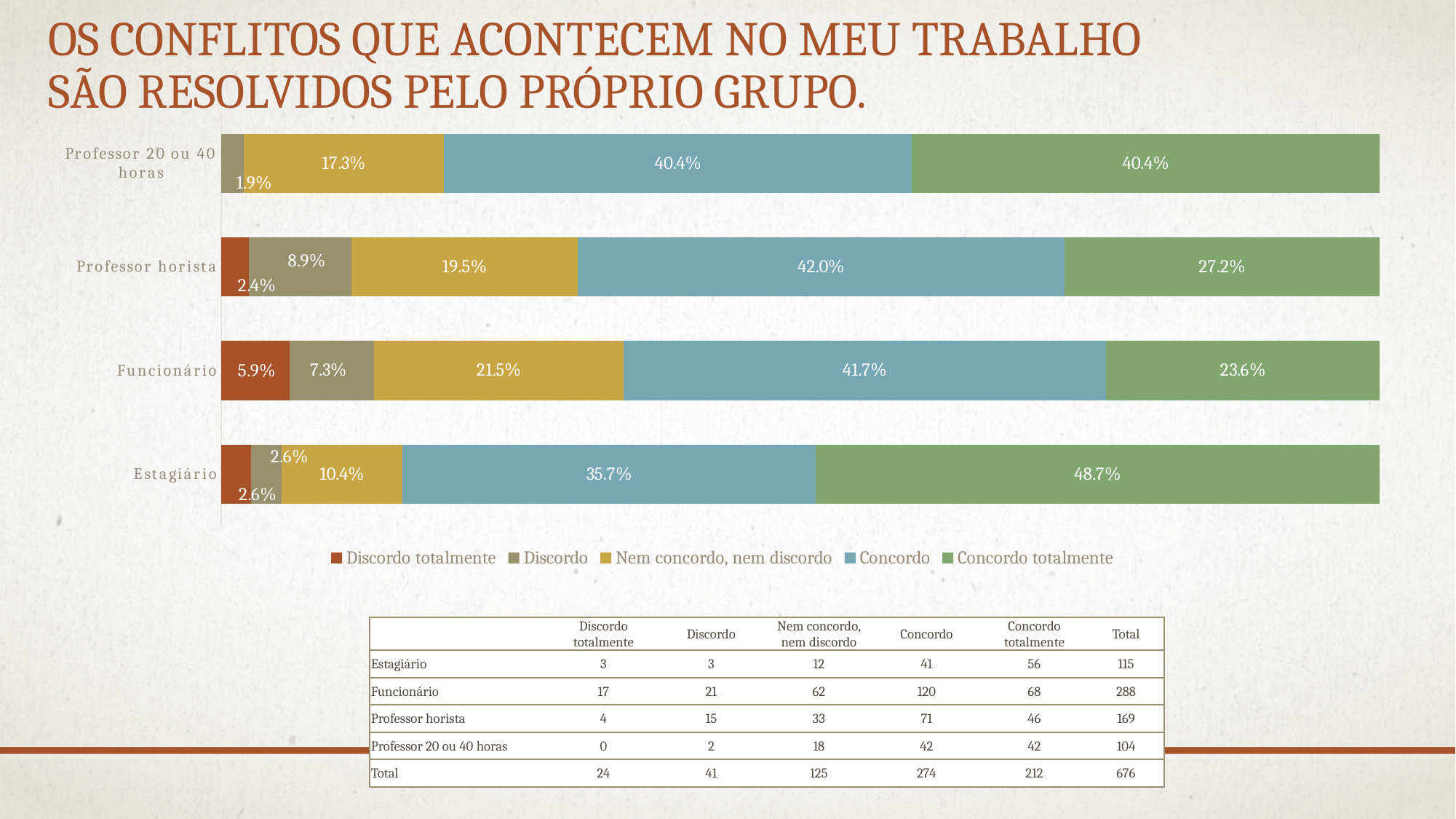
Which category has the highest value for Discordo totalmente? Funcionário Which category has the lowest value for Nem concordo, nem discordo? Estagiário What is the value for Discordo totalmente for Funcionário? 5.9% Which is larger, the Concordo value for Funcionário or for Professor 20 ou 40 horas? Funcionário How many series does the legend list? 5 What is the value for Concordo for Professor horista? 42.0% How many categories are shown on the chart? 4 What is the value for Concordo totalmente for Estagiário? 48.7% Which category has the highest value for Concordo totalmente? Estagiário What is the value for Discordo for Professor 20 ou 40 horas? 1.9% What kind of chart is shown on the slide? Stacked bar chart What is the difference between the Concordo totalmente values for Estagiário and Funcionário? 25.1 percentage points